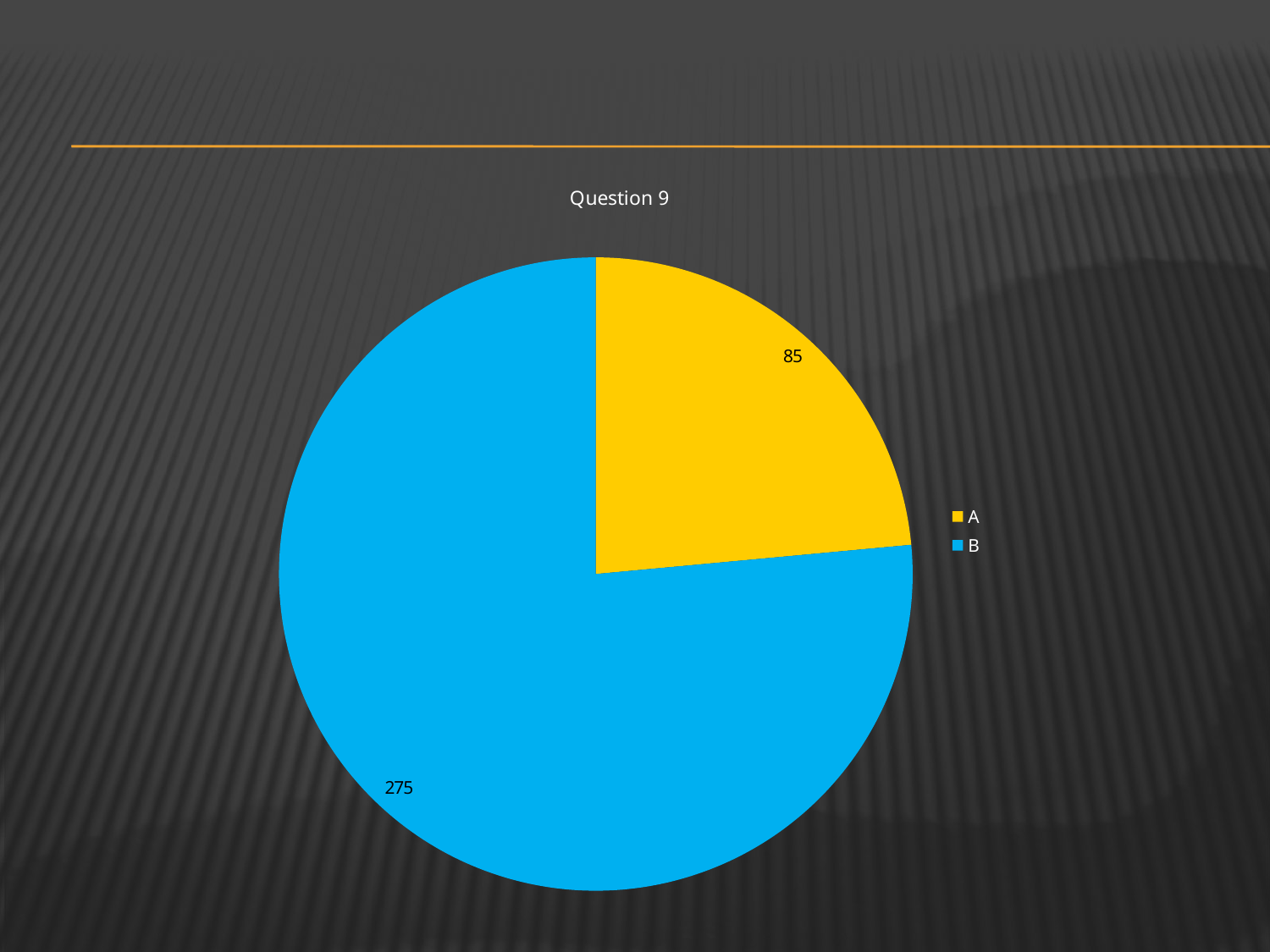
What is the value for B? 275 Which category has the largest slice? B How many slices does the pie chart have? 2 What kind of chart is shown on the slide? Pie chart How many entries does the legend list? 2 Which category has the smallest slice? A What is the value for A? 85 What is the difference between the values for B and A? 190 Which is larger, the value for A or the value for B? B What is the total of all slices in the pie chart? 360 What colour is the slice for B? Blue What is the title of the chart? Question 9